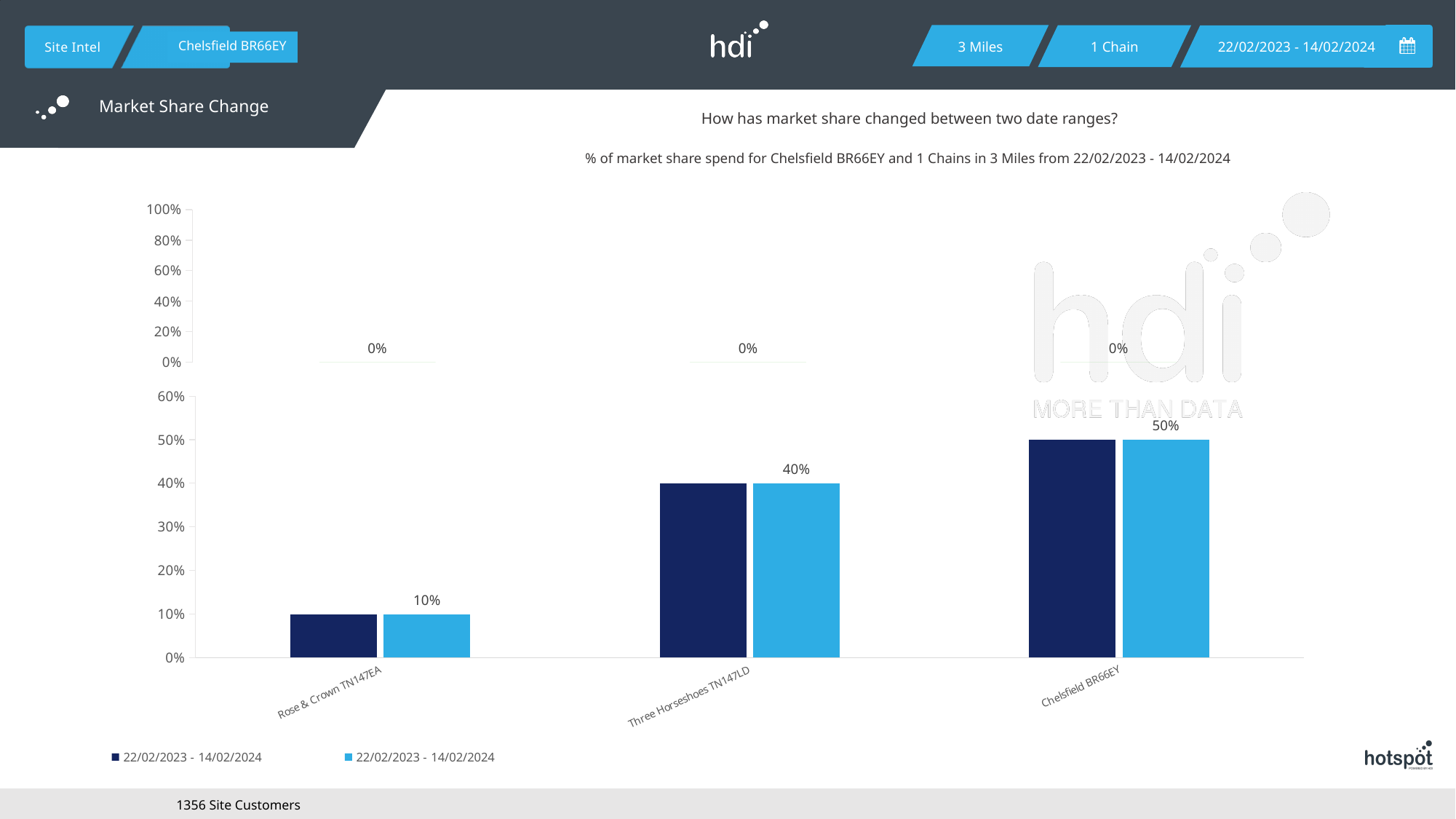
In the bottom chart, which category has the highest market share? Chelsfield BR66EY In the top chart, what value is labelled for Rose & Crown TN147EA? 0% In the bottom chart, which is larger: the market share of Three Horseshoes TN147LD or Rose & Crown TN147EA? Three Horseshoes TN147LD In the bottom chart, how many categories are shown on the x axis? 3 How many series does the legend at the bottom of the slide list? 2 What type of chart is the bottom chart? Bar chart In the bottom chart, what is the market share value shown for Chelsfield BR66EY? 50% In the bottom chart, what is the difference between the market share of Chelsfield BR66EY and Rose & Crown TN147EA? 40% In the bottom chart, what is the market share value shown for Three Horseshoes TN147LD? 40% In the bottom chart, what is the market share value shown for Rose & Crown TN147EA? 10% In the bottom chart, which category has the lowest market share? Rose & Crown TN147EA What is the subtitle text shown above the charts describing the data? % of market share spend for Chelsfield BR66EY and 1 Chains in 3 Miles from 22/02/2023 - 14/02/2024